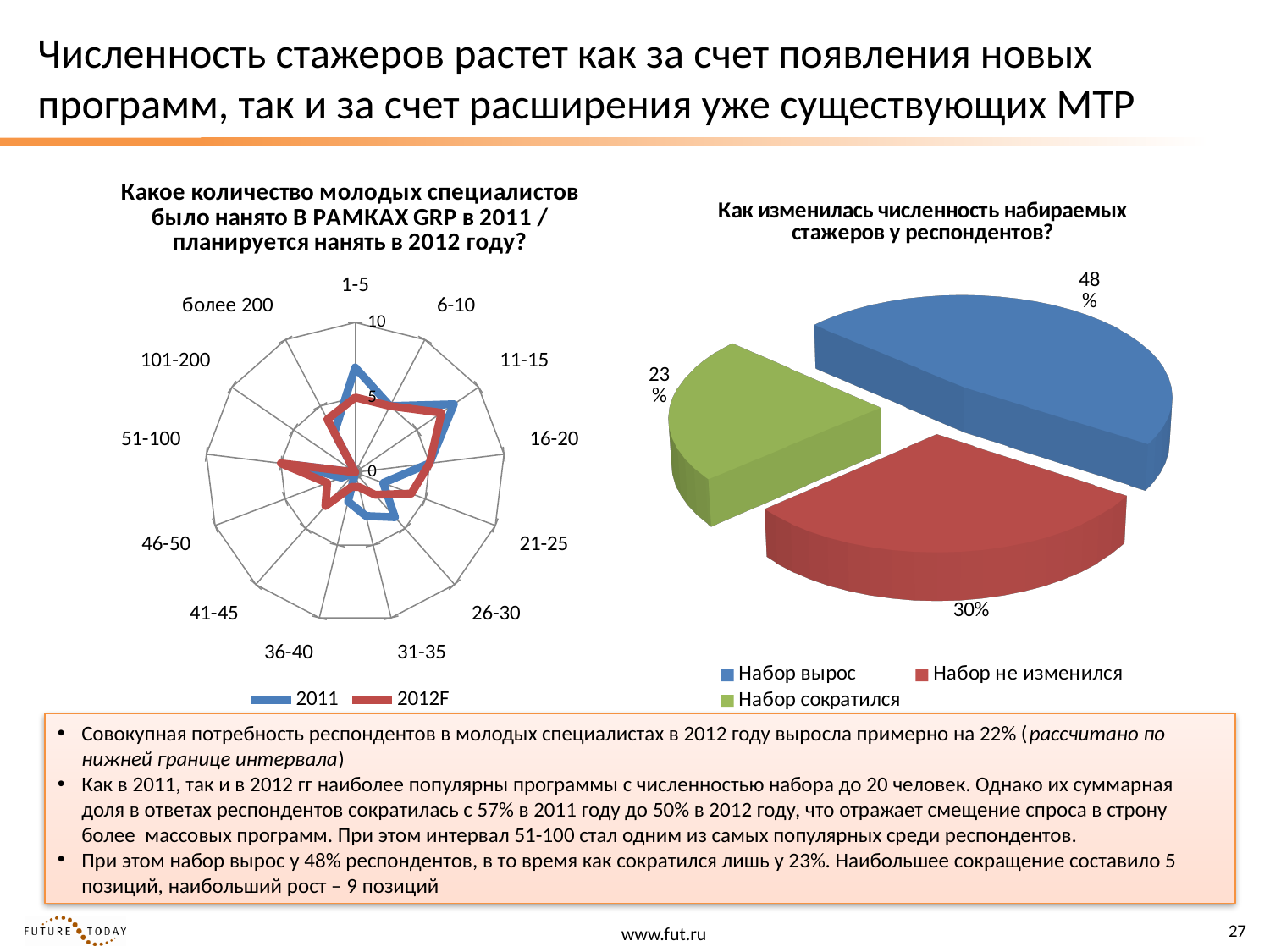
How many entries does the legend of the pie chart on the right list? 3 What kind of chart is the chart on the right titled "Как изменилась численность набираемых стажеров у респондентов?"? Pie chart In the radar chart on the left, is the 2011 value for the category "1-5" greater or less than 5? greater How many categories are plotted around the radar chart on the left? 13 How many series does the legend of the radar chart on the left list? 2 In the pie chart on the right, what share of respondents answered "Набор вырос"? 48% In the pie chart on the right, which answer has the largest share? Набор вырос What kind of chart is the chart on the left titled "Какое количество молодых специалистов было нанято В РАМКАХ GRP в 2011 / планируется нанять в 2012 году?"? Radar chart In the pie chart on the right, which answer has the smallest share? Набор сократился In the pie chart on the right, what is the difference in percentage points between "Набор вырос" and "Набор не изменился"? 18 percentage points In the pie chart on the right, what share of respondents answered "Набор не изменился"? 30% In the pie chart on the right, what share of respondents answered "Набор сократился"? 23%